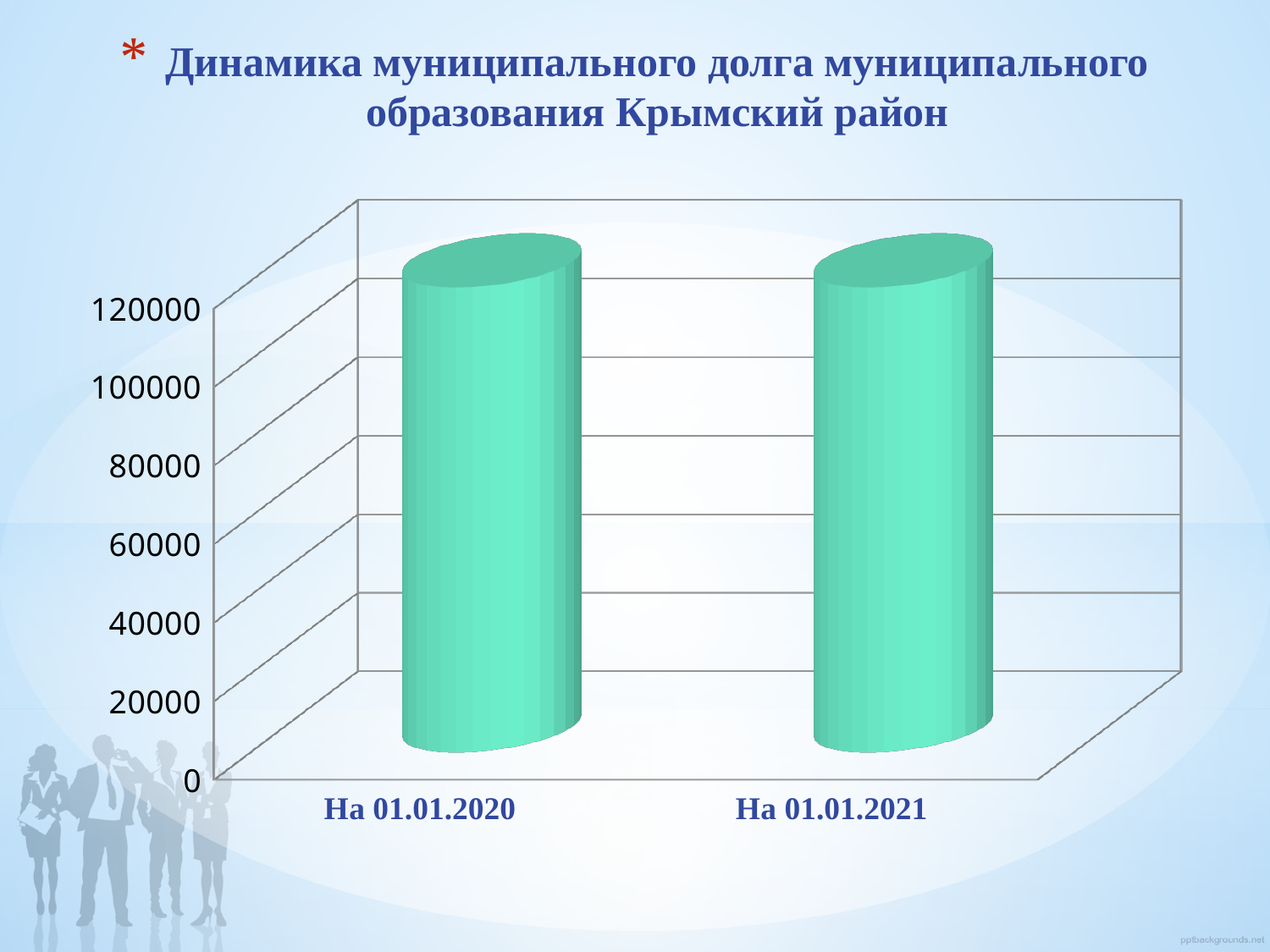
Is the value for На 01.01.2021 greater or less than 60000? greater Is the value for На 01.01.2021 greater or less than 100000? greater What kind of chart is shown on the slide? bar chart What is the label of the first category on the x axis? На 01.01.2020 Is the value for На 01.01.2020 greater or less than 100000? greater What is the title of the chart on the slide? Динамика муниципального долга муниципального образования Крымский район What is the highest tick value shown on the vertical axis? 120000 How many categories are shown on the x axis of the chart? 2